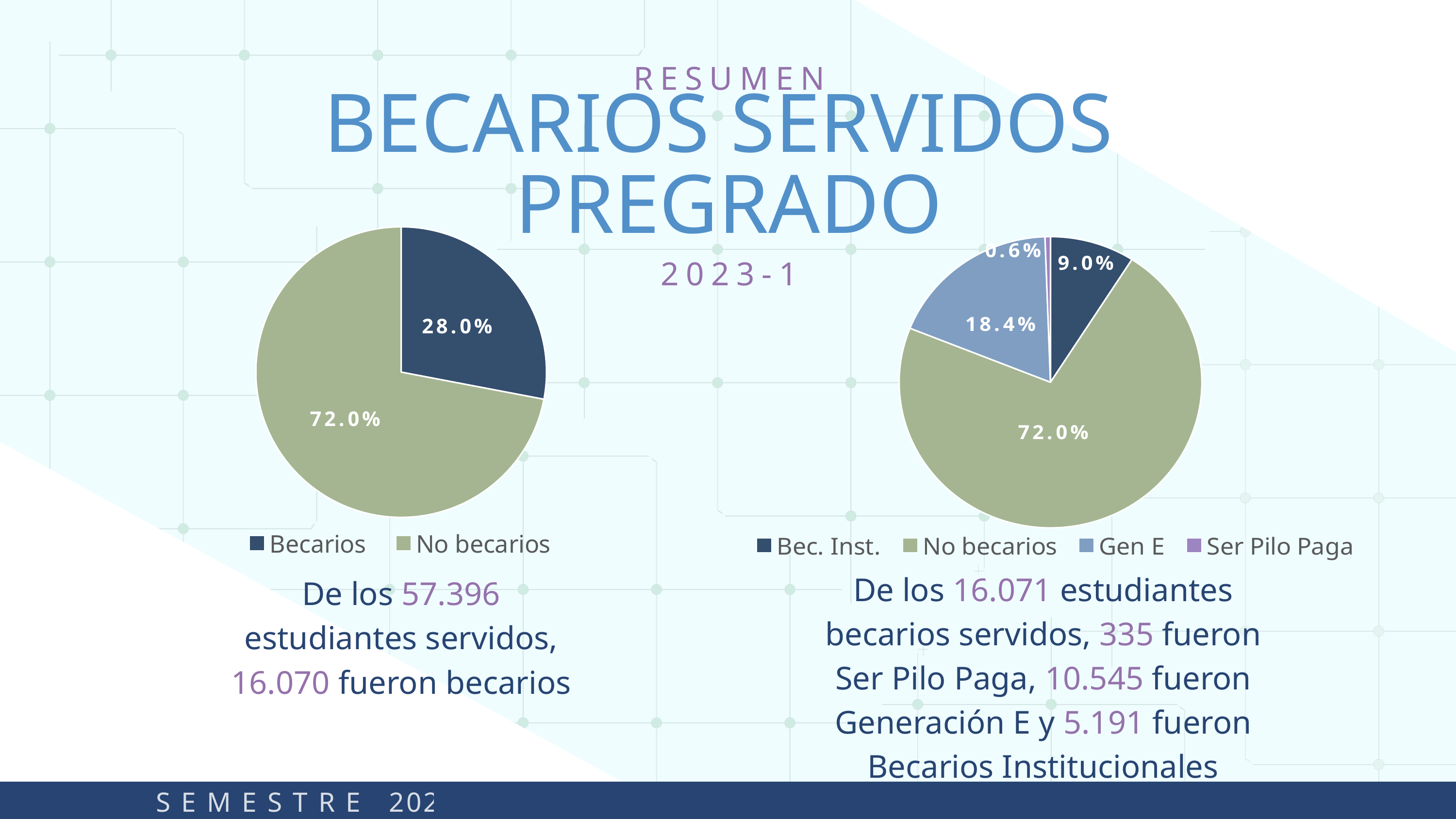
In the right pie chart, what share is labelled for Bec. Inst.? 9.0% In the right pie chart, which category has the largest slice? No becarios In the right pie chart, which category has the smallest slice? Ser Pilo Paga In the right pie chart, what share is labelled for Ser Pilo Paga? 0.6% How many slices does the left pie chart have? 2 How many entries does the legend of the right pie chart list? 4 What kind of chart is the left chart? Pie chart In the left pie chart, which slice is larger, Becarios or No becarios? No becarios In the right pie chart, what is the difference in percentage points between Gen E and Bec. Inst.? 9.4 In the left pie chart, what share is labelled for No becarios? 72.0% In the right pie chart, what share is labelled for Gen E? 18.4% In the left pie chart, what share is labelled for Becarios? 28.0%